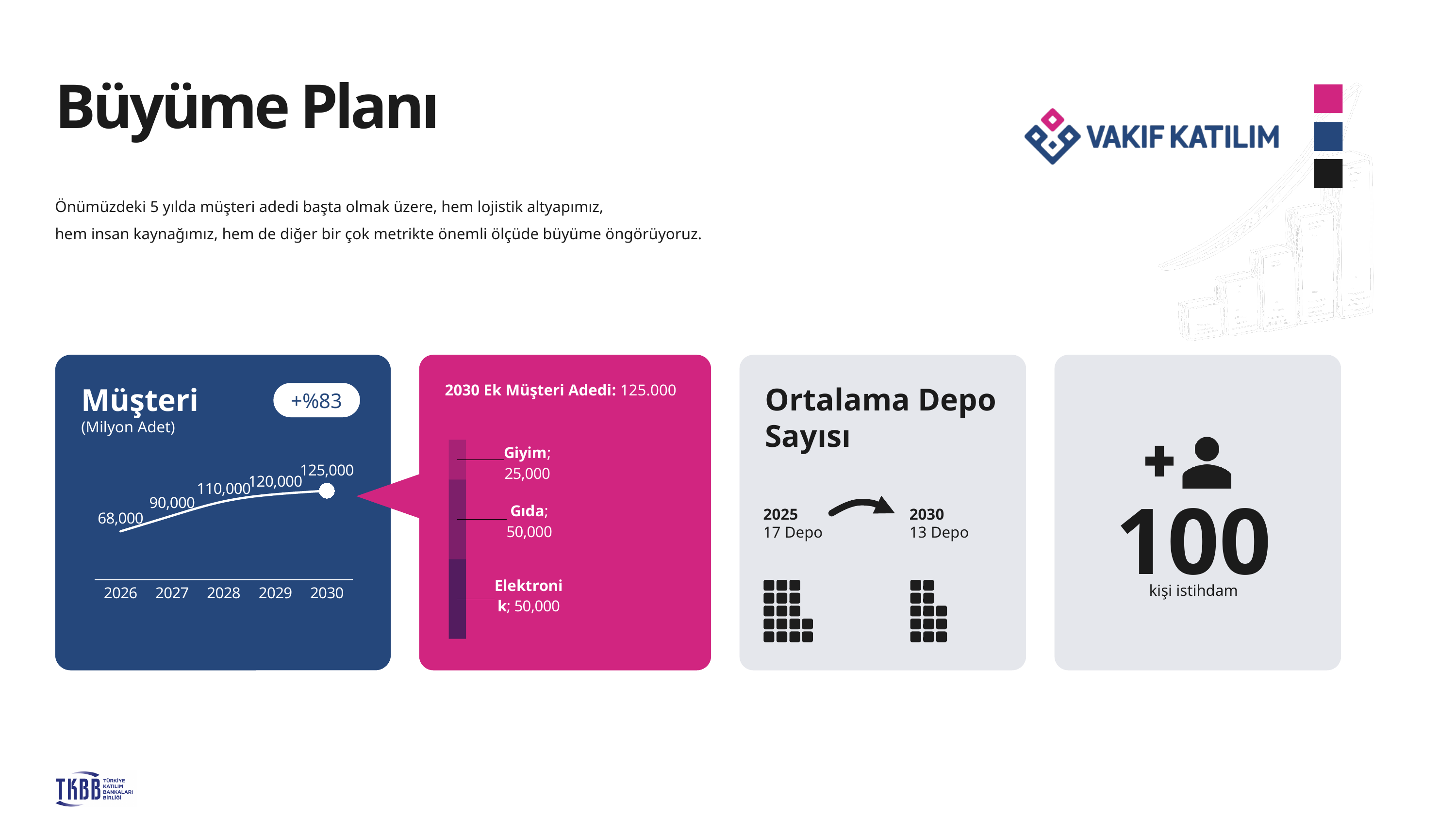
In the Müşteri line chart, what is the value for 2026? 68,000 How many years are plotted in the Müşteri line chart? 5 In the 2030 Ek Müşteri Adedi stacked bar, which segment is the smallest? Giyim In the Müşteri line chart, do the values rise or fall from 2026 to 2030? rise In the 2030 Ek Müşteri Adedi stacked bar, what is the value for Gıda? 50,000 In the Müşteri line chart, which year has the lowest value? 2026 In the 2030 Ek Müşteri Adedi stacked bar, what is the total of all segments? 125,000 In the Müşteri line chart, what is the value for 2028? 110,000 In the Müşteri line chart, which year has the highest value? 2030 What kind of chart is shown in the Müşteri panel? line chart In the Müşteri line chart, what is the difference between the 2027 and 2026 values? 22,000 In the 2030 Ek Müşteri Adedi stacked bar, is the value for Elektronik larger or smaller than the value for Giyim? larger